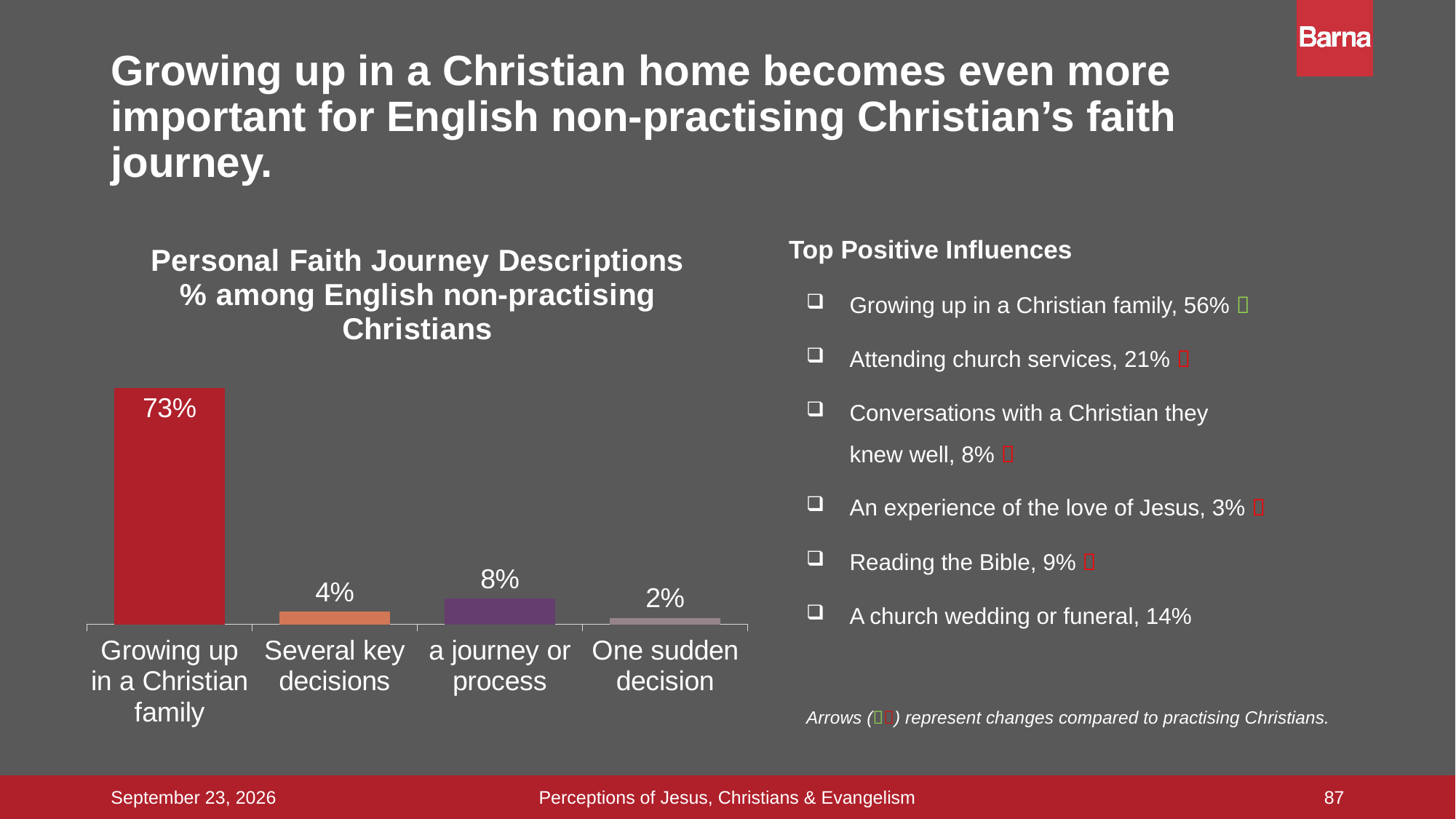
What is the value for 'Growing up in a Christian family' in the Personal Faith Journey Descriptions chart? 73% What is the title of the chart? Personal Faith Journey Descriptions % among English non-practising Christians What is the value for 'One sudden decision' in the chart? 2% How many categories are shown in the chart? 4 What is the difference between the values for 'Several key decisions' and 'One sudden decision'? 2% Which category has the lowest value in the chart? One sudden decision What kind of chart is shown on the slide? Bar chart What is the difference between the values for 'Growing up in a Christian family' and 'a journey or process'? 65% What is the value for 'a journey or process' in the chart? 8% What is the value for 'Several key decisions' in the chart? 4% Which is larger: the value for 'a journey or process' or the value for 'Several key decisions'? a journey or process Which category has the highest value in the chart? Growing up in a Christian family